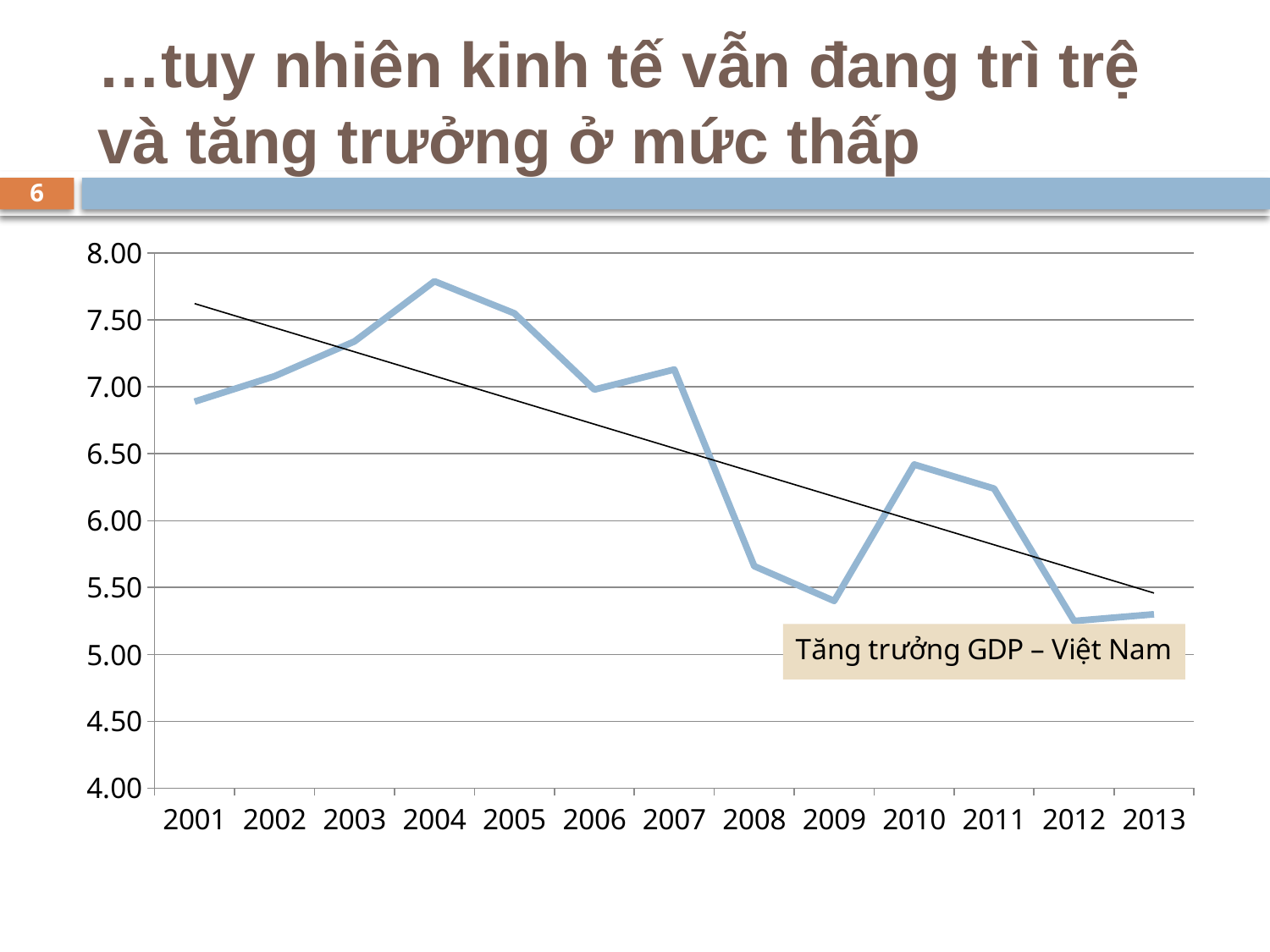
In which year does the GDP growth line reach its highest value? 2004 Is the value for 2010 greater or less than 6.00? greater How many years are plotted on the x axis of the chart? 13 Is the value for 2009 greater or less than 5.50? less Is the value for 2003 greater or less than 7.00? greater Overall, do the values rise or fall from 2001 to 2013? fall What label is shown in the box on the chart identifying the data series? Tăng trưởng GDP – Việt Nam Which year has the larger value, 2010 or 2009? 2010 What kind of chart is shown on the slide? Line chart Which year has the larger value, 2003 or 2008? 2003